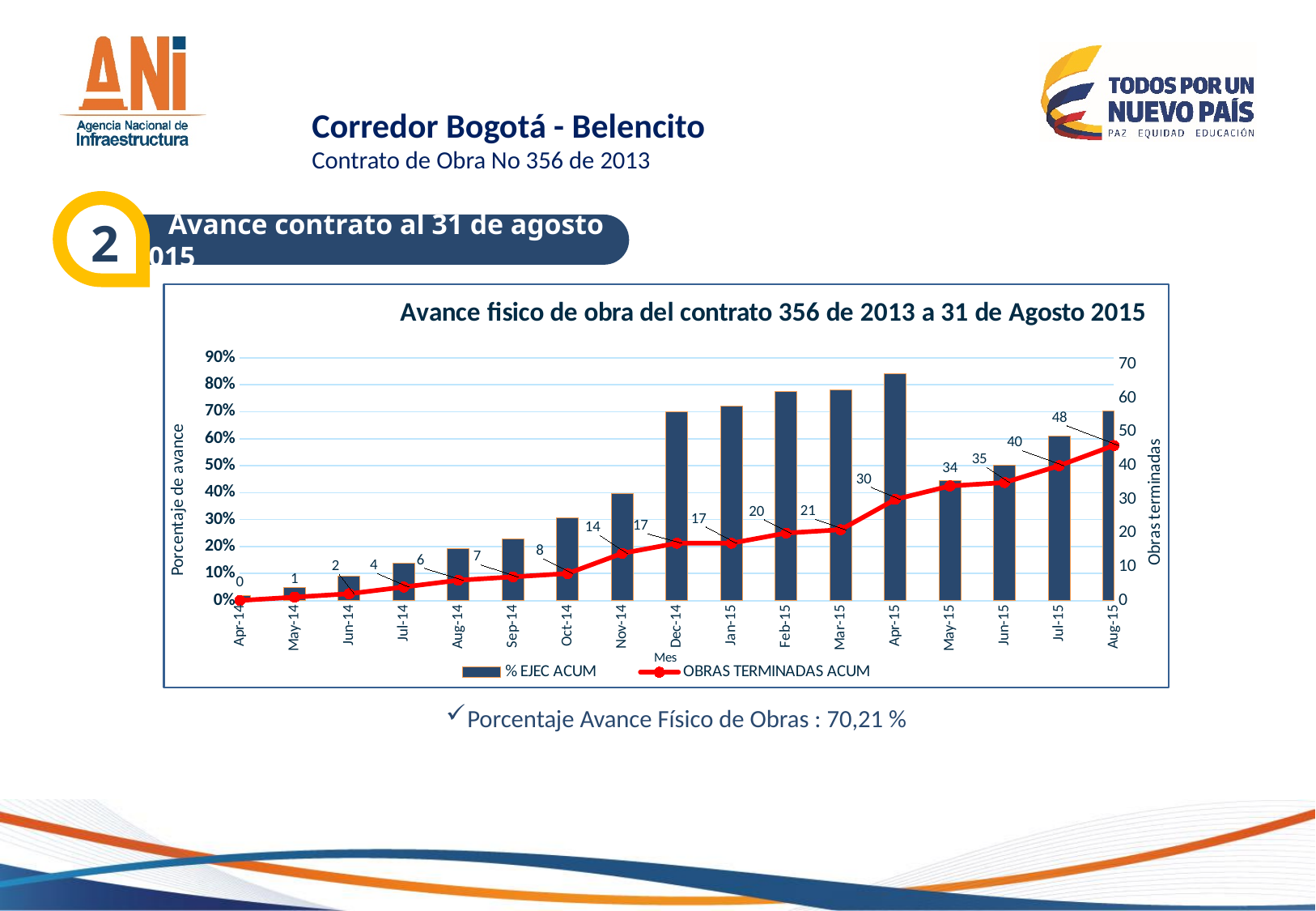
What is the value of OBRAS TERMINADAS ACUM for Aug-15? 48 Which month has the lowest OBRAS TERMINADAS ACUM value? Apr-14 Which month has the highest % EJEC ACUM bar? Apr-15 What is the value of OBRAS TERMINADAS ACUM for Apr-15? 30 How many series does the legend list? 2 What is the difference in OBRAS TERMINADAS ACUM between Aug-15 and Jul-15? 8 Is the % EJEC ACUM value for Dec-14 greater or less than 60%? greater What is the difference in OBRAS TERMINADAS ACUM between Apr-15 and Mar-15? 9 What is the value of OBRAS TERMINADAS ACUM for Jul-14? 4 Is the % EJEC ACUM value for Oct-14 greater or less than 20%? greater How many months are shown on the x axis? 17 What is the value of OBRAS TERMINADAS ACUM for Nov-14? 14